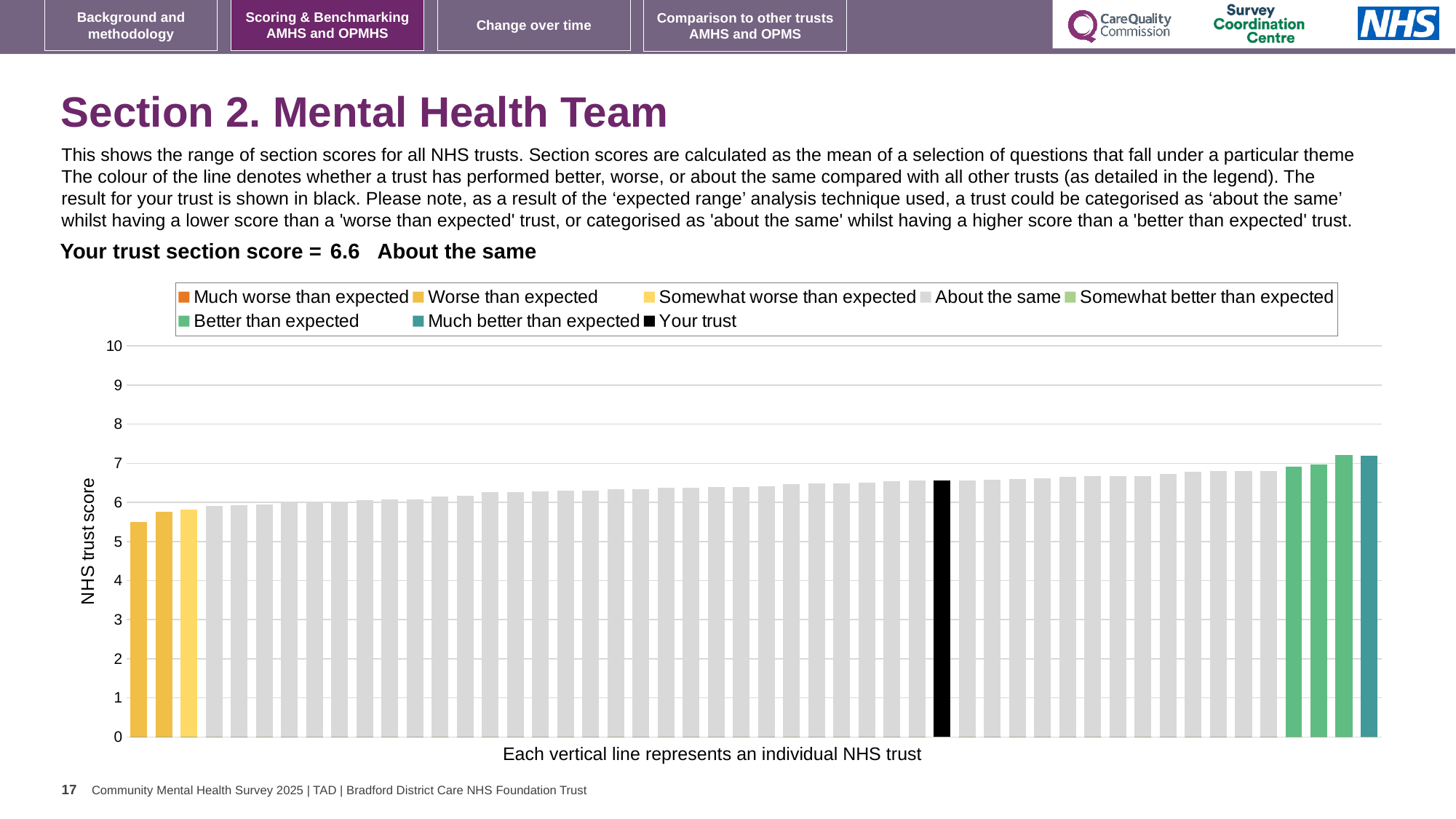
What is the label on the vertical axis of the chart? NHS trust score Do the bar values rise or fall from left to right across the chart? rise Is the value of the rightmost bar greater or less than 7? greater Which bar is taller: the leftmost bar or the rightmost bar? the rightmost bar What kind of chart is shown on the slide? bar chart Is the value of the leftmost bar greater or less than 6? less How is your trust categorised compared with other trusts, according to the text above the chart? About the same What colour does the legend assign to 'Your trust'? black How many entries does the chart legend list? 8 What is the section score for your trust, as printed on the slide? 6.6 Is the value of the black bar (your trust) greater or less than 6? greater